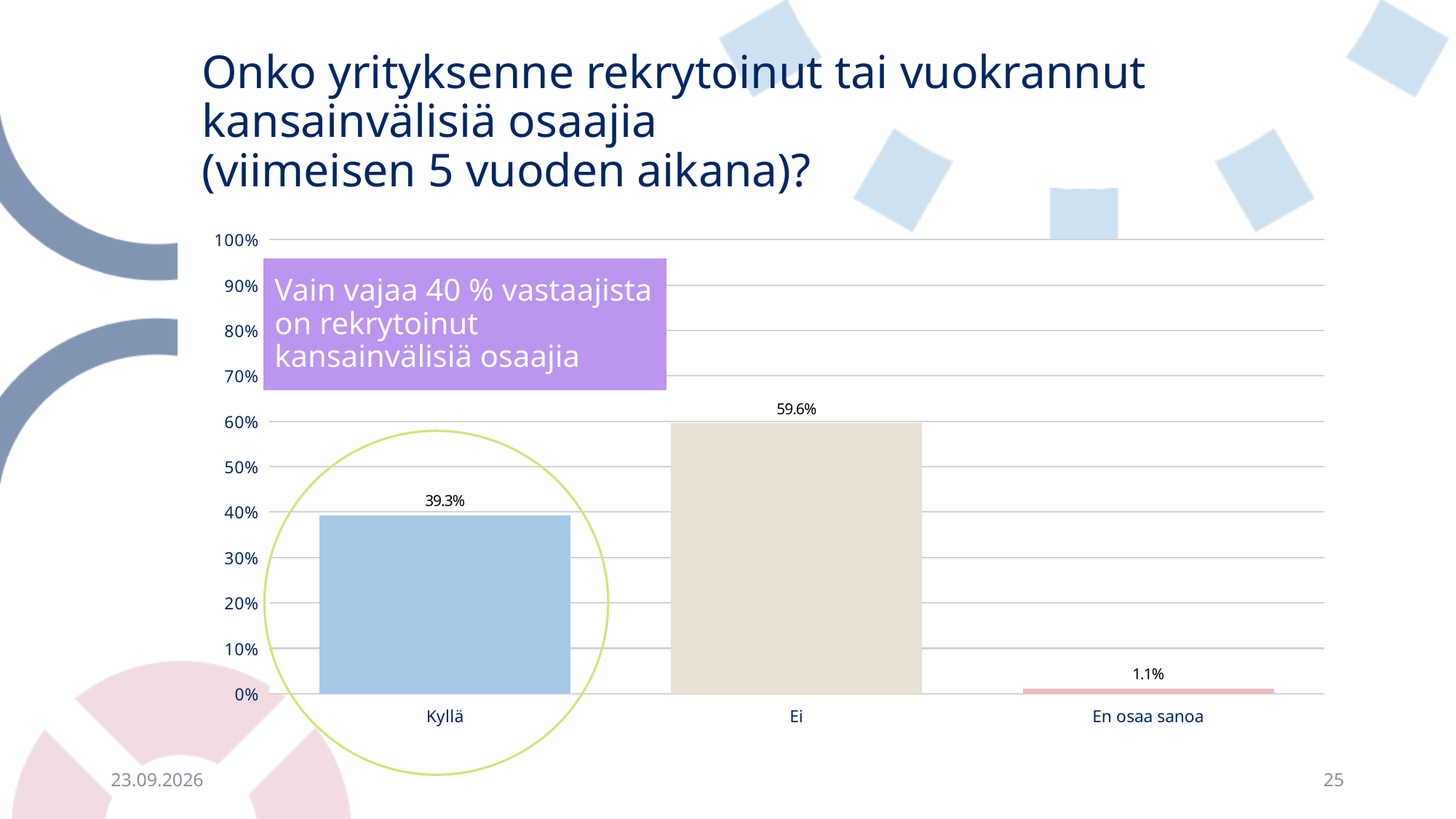
Is the value for Kyllä greater or less than 40%? less How many categories are shown on the x axis? 3 Which category has the highest value? Ei Which is larger, the value for Kyllä or the value for Ei? Ei What kind of chart is shown on the slide? bar chart What is the difference between the values for Ei and Kyllä? 20.3% What is the value for Ei? 59.6% What is the value for En osaa sanoa? 1.1% Is the value for Ei greater or less than 50%? greater What is the value for Kyllä? 39.3% Which category has the lowest value? En osaa sanoa Which category's bar is circled on the slide? Kyllä